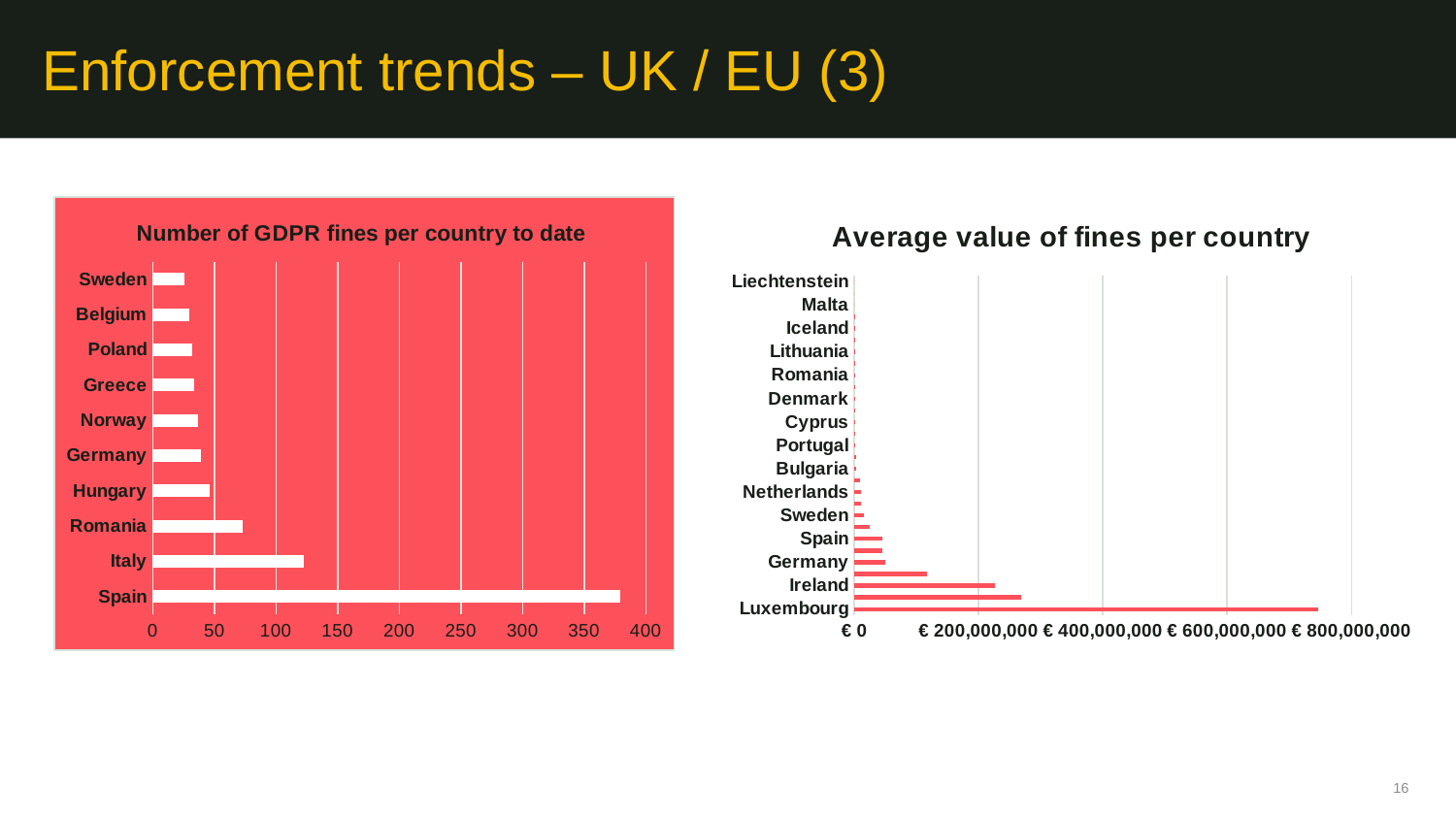
What is the title of the chart on the right side of the slide? Average value of fines per country On the 'Number of GDPR fines per country to date' chart, how many countries are listed? 10 On the 'Average value of fines per country' chart, which country has a higher average fine value, Luxembourg or Ireland? Luxembourg On the 'Average value of fines per country' chart, is the value for Luxembourg greater or less than € 600,000,000? greater On the 'Number of GDPR fines per country to date' chart, is the value for Germany greater or less than 50? less On the 'Number of GDPR fines per country to date' chart, is the value for Italy greater or less than 100? greater On the 'Average value of fines per country' chart, which country has the highest average fine value? Luxembourg On the 'Number of GDPR fines per country to date' chart, which country has the highest number of fines? Spain On the 'Number of GDPR fines per country to date' chart, what kind of chart is shown? Bar chart On the 'Number of GDPR fines per country to date' chart, which has more fines, Italy or Romania? Italy